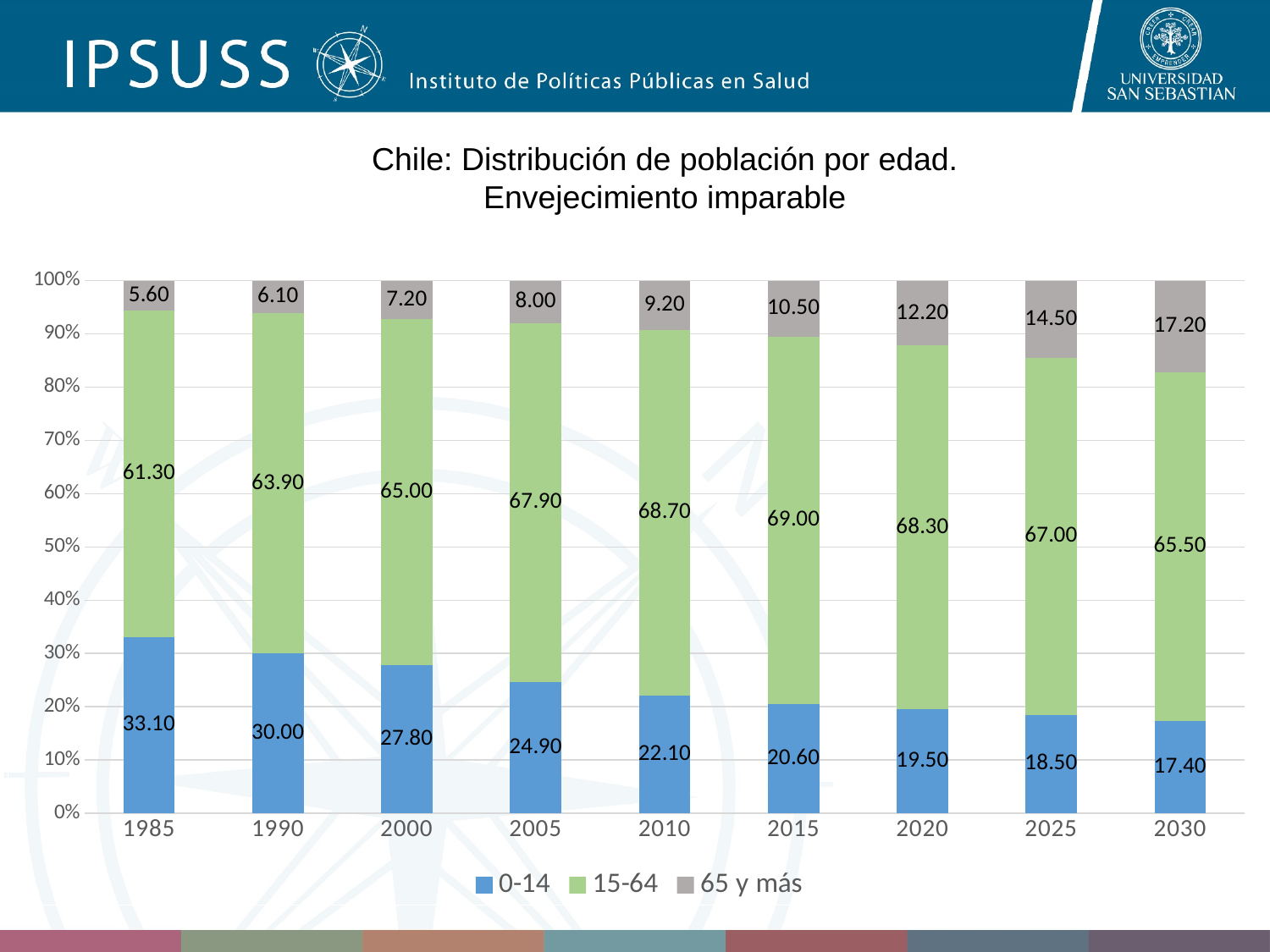
What kind of chart is shown on the slide? Stacked bar chart In which year is the 0-14 value lowest? 2030 How many years are shown on the x axis? 9 What is the difference between the 0-14 values in 1985 and 2030? 15.70 In which year is the 65 y más value highest? 2030 What is the value for the 15-64 series in 2015? 69.00 How many series does the legend list? 3 What is the value for the 0-14 series in 1985? 33.10 What is the title of the chart? Chile: Distribución de población por edad. Envejecimiento imparable What is the value for the 65 y más series in 2030? 17.20 Which is larger, the 15-64 value in 2000 or in 2025? 2025 Does the 0-14 value rise or fall from 1985 to 2030? Fall